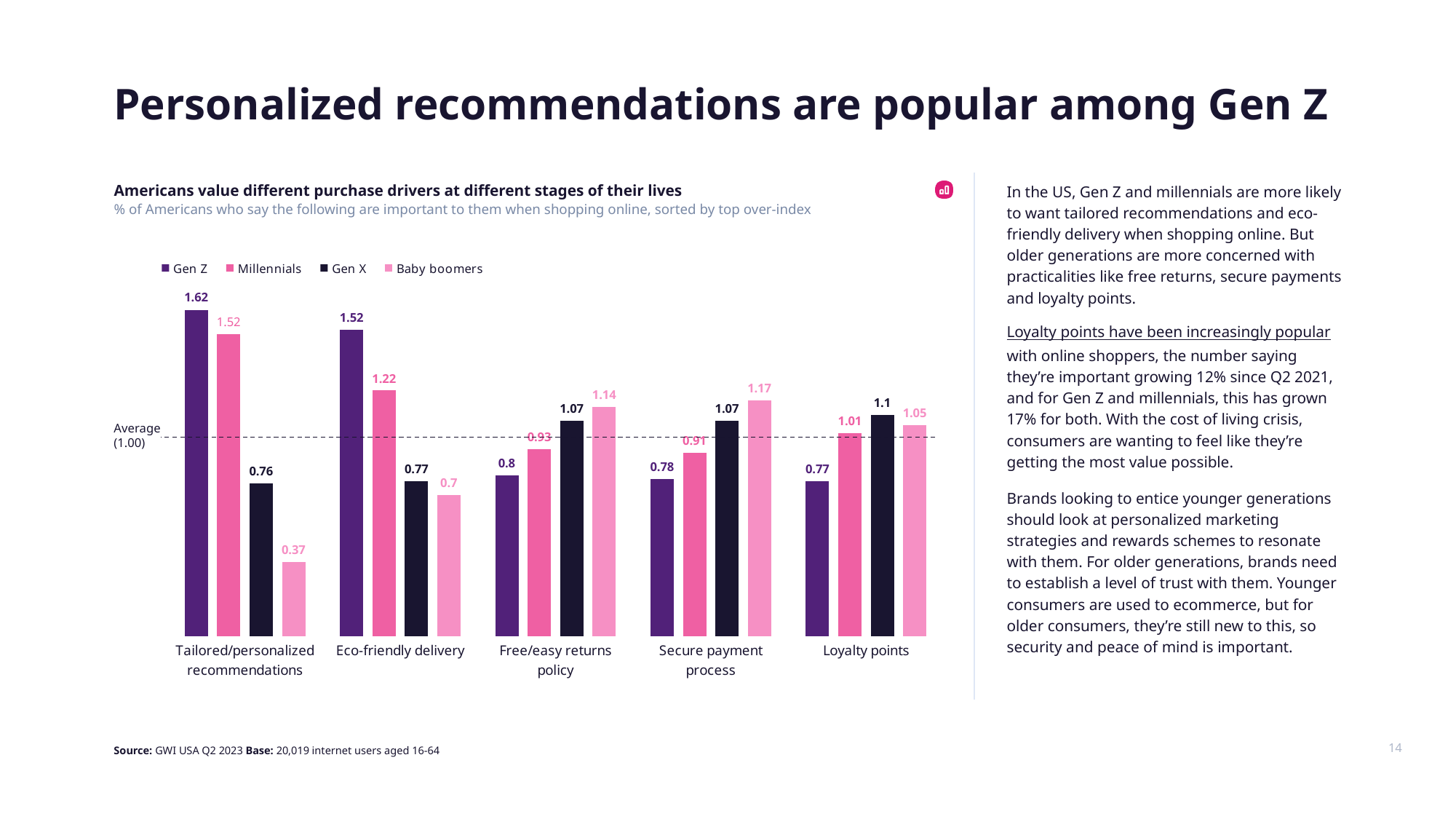
What is the Gen Z value for Tailored/personalized recommendations? 1.62 How many series does the legend list? 4 Which generation has the highest value for Secure payment process? Baby boomers What is the Gen X value for Loyalty points? 1.1 What is the difference between the Gen Z and Gen X values for Tailored/personalized recommendations? 0.86 What is the Millennials value for Eco-friendly delivery? 1.22 What kind of chart is shown on the slide? Bar chart What value does the dashed horizontal line labelled 'Average' represent? 1.00 What is the Baby boomers value for Tailored/personalized recommendations? 0.37 How many purchase driver categories are shown on the x axis? 5 Which generation has the lowest value for Free/easy returns policy? Gen Z Which is larger for Eco-friendly delivery: the Gen X value or the Baby boomers value? Gen X